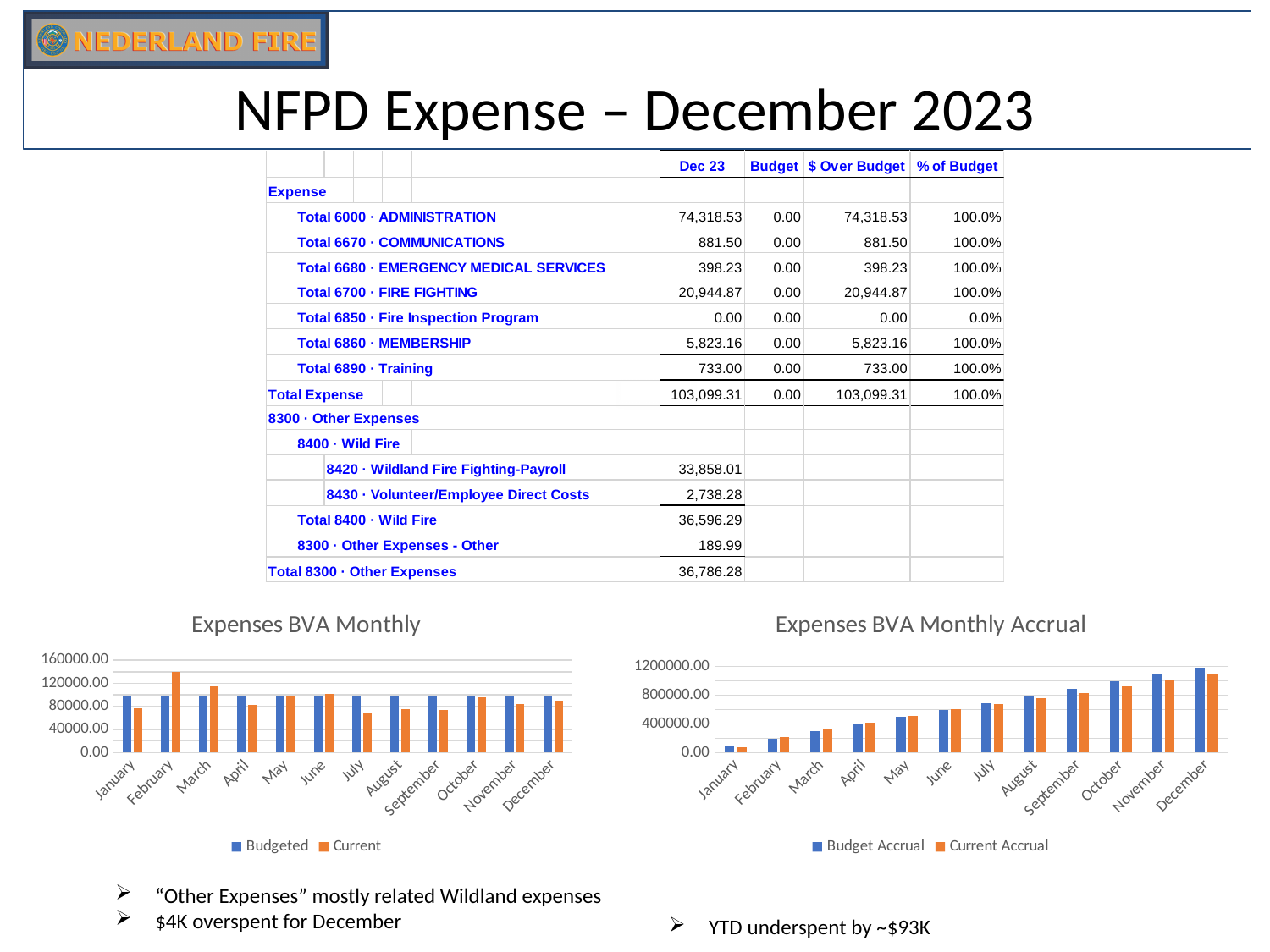
In the "Expenses BVA Monthly Accrual" chart, which month has the highest Budget Accrual value? December In the "Expenses BVA Monthly" chart, which is larger for February, Budgeted or Current? Current How many series does the legend of the "Expenses BVA Monthly" chart list? 2 What kind of chart is the "Expenses BVA Monthly" chart? bar chart How many months are shown on the x axis of the "Expenses BVA Monthly Accrual" chart? 12 In the "Expenses BVA Monthly" chart, is the Budgeted value for January greater or less than 80000? greater In the "Expenses BVA Monthly" chart, is the Current value for February greater or less than 120000? greater In the "Expenses BVA Monthly Accrual" chart, do the Budget Accrual values rise or fall from January to December? rise In the "Expenses BVA Monthly" chart, is the Current value for July greater or less than 80000? less What are the two legend entries of the "Expenses BVA Monthly Accrual" chart? Budget Accrual and Current Accrual In the "Expenses BVA Monthly" chart, which month has the highest Current value? February